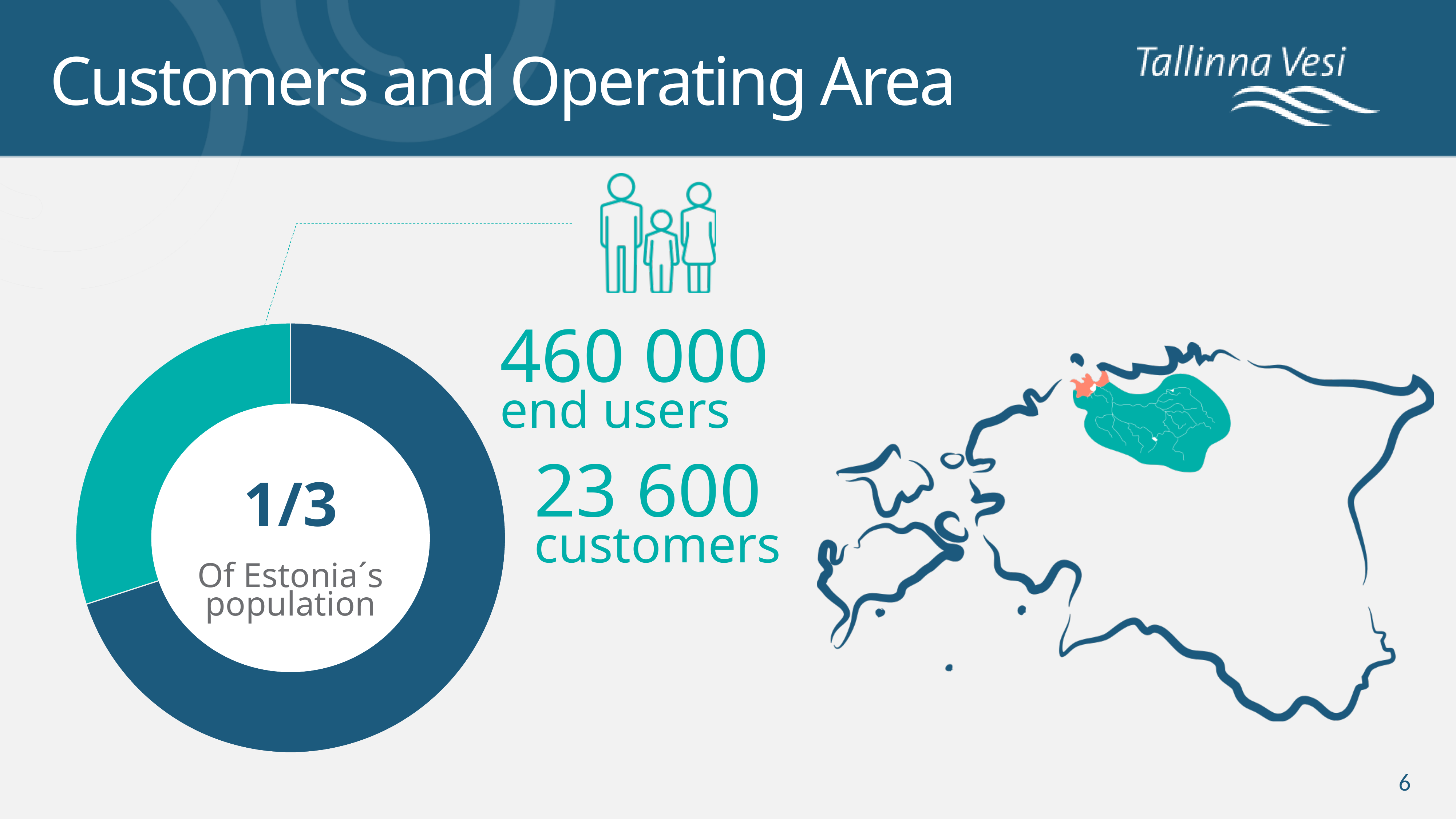
How many end users does the teal segment of the donut chart correspond to, according to the slide? 460 000 What kind of chart is shown on the left of the slide? Pie chart (donut) What share of Estonia's population does the teal segment of the donut chart represent? 1/3 Is the teal segment of the donut chart greater or less than half of the whole? less Which segment of the donut chart is larger, the teal one or the dark blue one? The dark blue one How many segments does the donut chart have? 2 What colour is the segment of the donut chart that represents 1/3 of Estonia's population? Teal What text is printed in the centre of the donut chart? 1/3 Of Estonia´s population